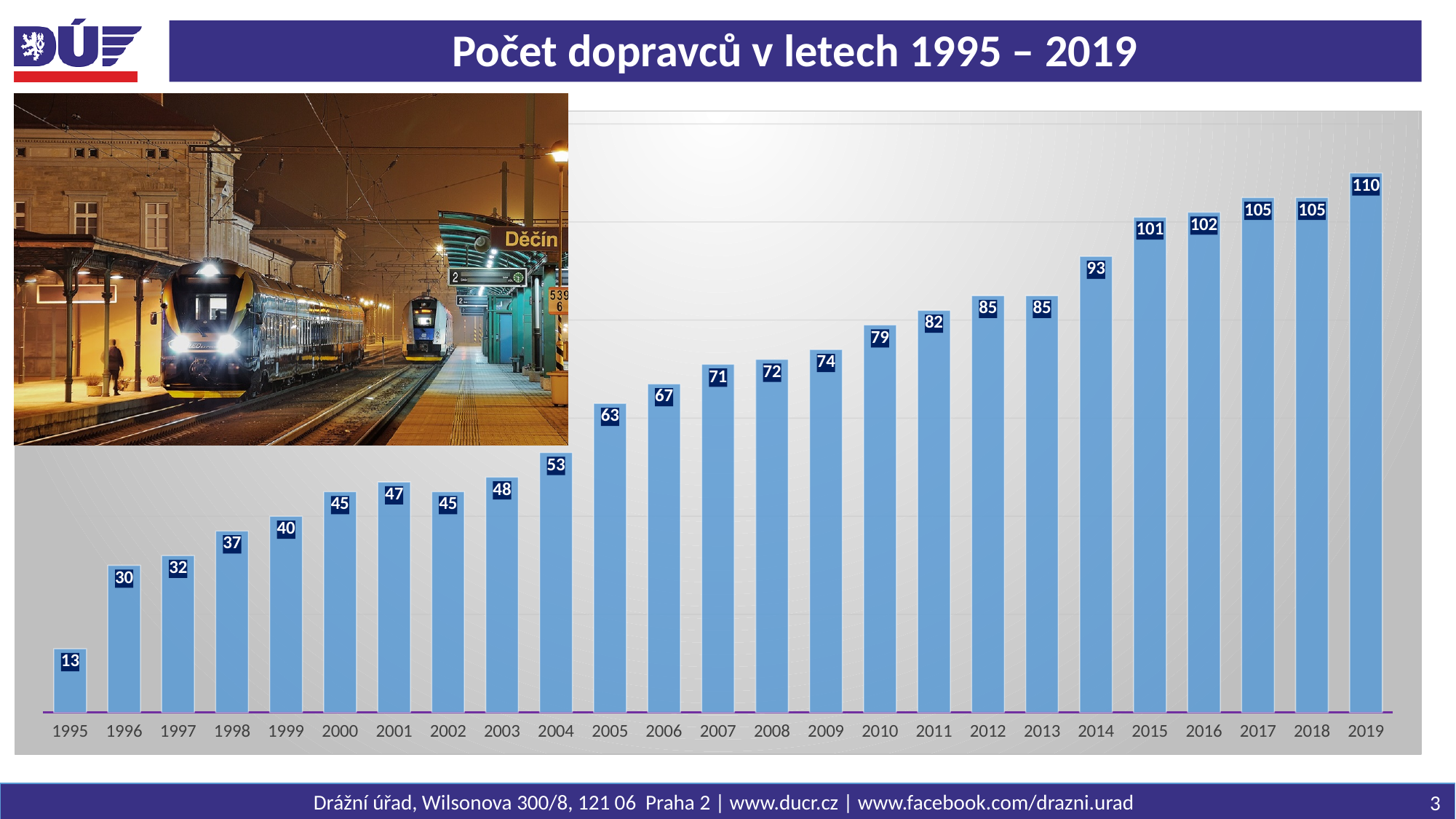
What kind of chart is shown on the slide? bar chart What is the value for 2004? 53 What is the value for 2014? 93 Do the values generally rise or fall from 1995 to 2019? rise How many years are shown on the x axis? 25 What is the value for 1995? 13 Which is larger, the value for 2001 or the value for 2002? 2001 Which year has the highest value? 2019 What is the title of the chart? Počet dopravců v letech 1995 – 2019 What is the difference between the values for 2019 and 1995? 97 What is the difference between the values for 2015 and 2014? 8 Which year has the lowest value? 1995